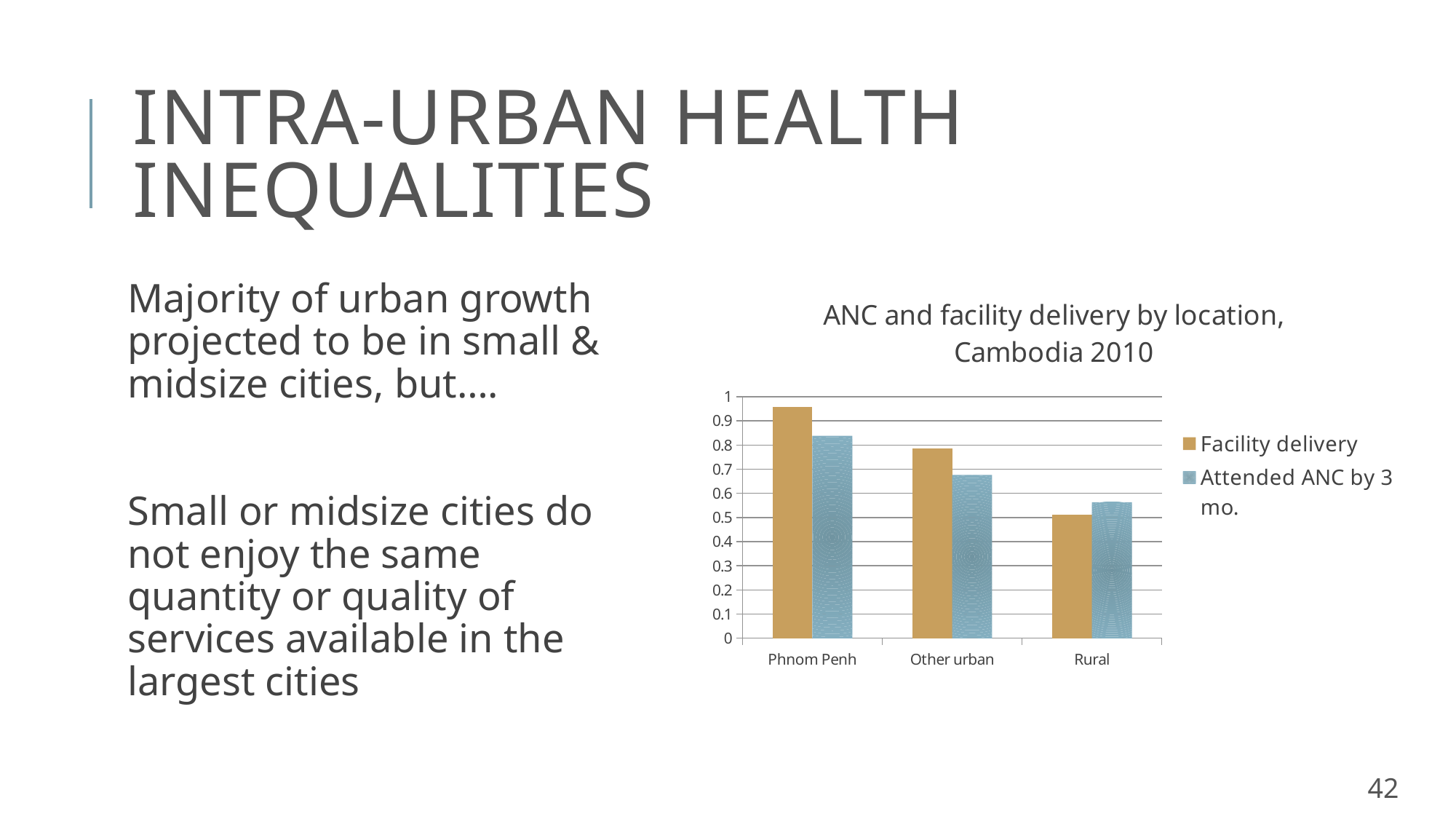
For Rural, which is larger: Facility delivery or Attended ANC by 3 mo.? Attended ANC by 3 mo. How many series does the chart legend list? 2 What kind of chart is shown on the slide? bar chart Which location has the highest Facility delivery value? Phnom Penh Is the Facility delivery value for Other urban greater or less than 0.7? greater Is the Facility delivery value for Phnom Penh greater or less than 0.9? greater Is the Facility delivery value for Rural greater or less than 0.6? less How many location categories are shown on the x axis? 3 Which location has the lowest Attended ANC by 3 mo. value? Rural Does the Facility delivery value rise or fall moving from Phnom Penh to Rural along the x axis? fall What is the title of the chart? ANC and facility delivery by location, Cambodia 2010